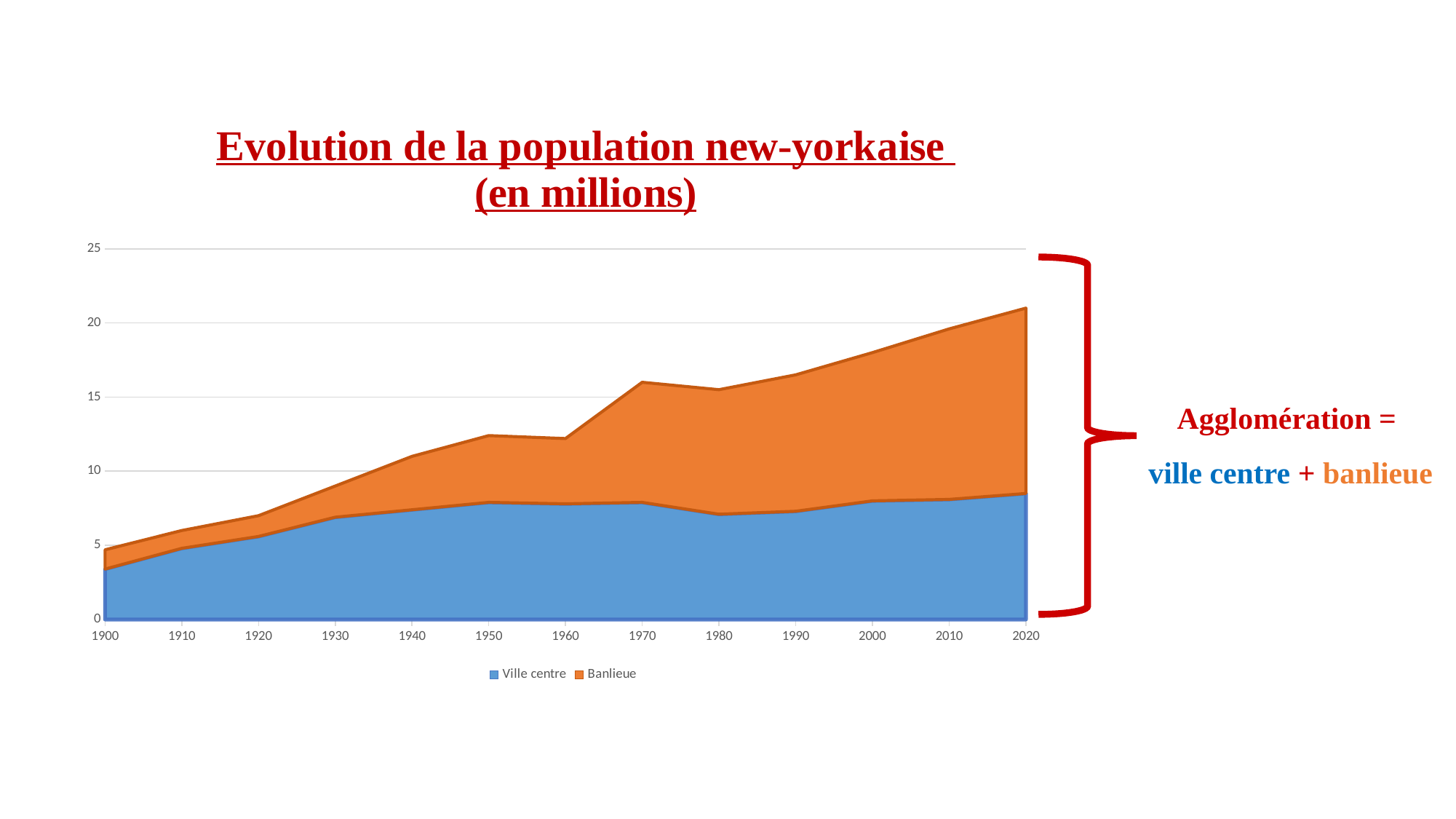
Is the value for Ville centre in 1900 greater or less than 5? less How many series does the legend list? 2 How many years are plotted along the x axis? 13 What kind of chart is shown on the slide? Stacked area chart Does the total population generally rise or fall from 1900 to 2020? rise Is the total population (Ville centre + Banlieue) in 1950 greater or less than 10? greater Is the total population (Ville centre + Banlieue) in 1970 greater or less than 15? greater Which series is shown in orange? Banlieue In which year is the total population (Ville centre + Banlieue) highest? 2020